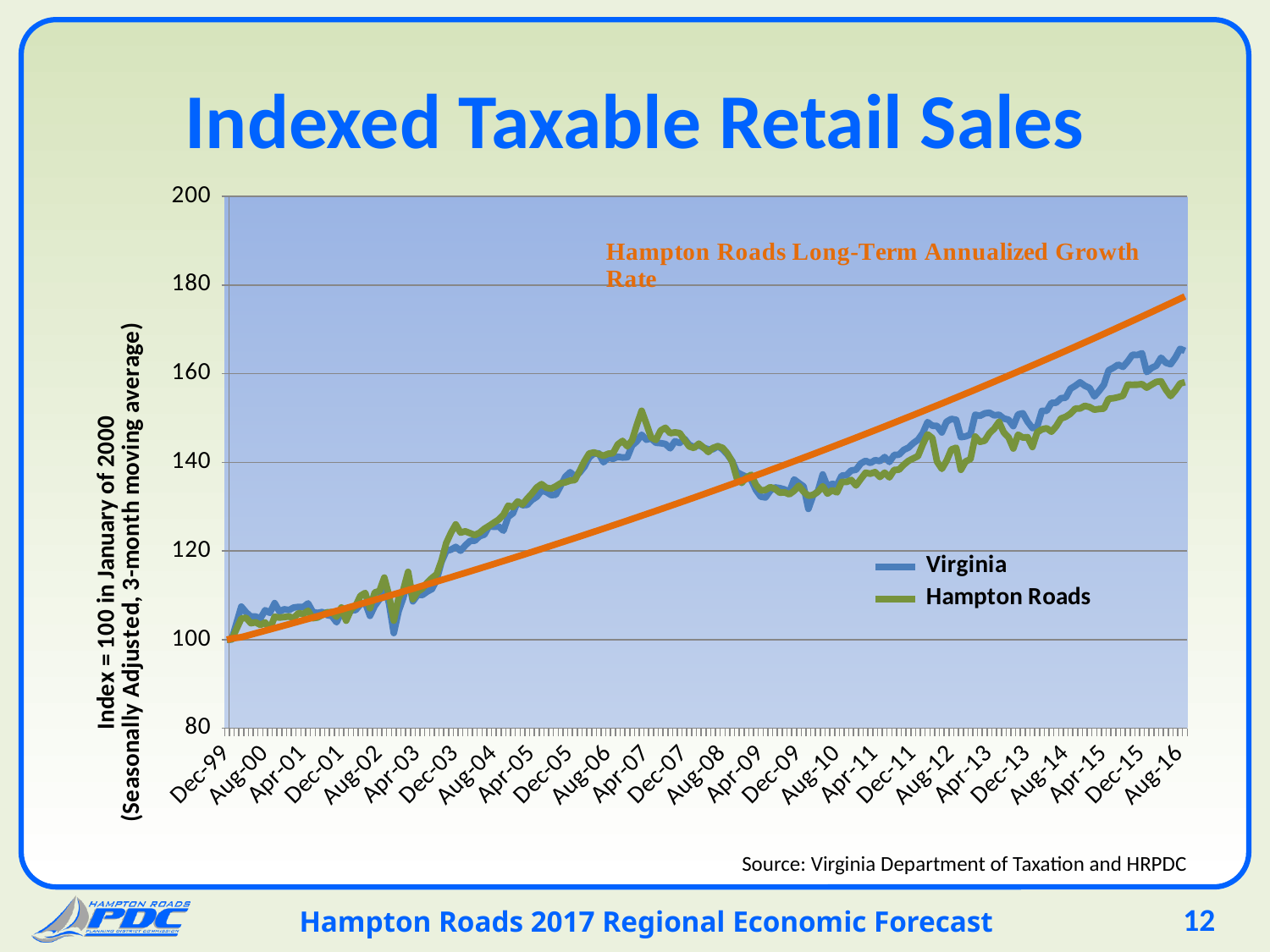
What does the orange line on the chart represent? Hampton Roads Long-Term Annualized Growth Rate What is the title of the chart? Indexed Taxable Retail Sales At Aug-16, which series has the higher value, Virginia or Hampton Roads? Virginia Is the value for Hampton Roads at Aug-16 greater or less than 140? greater Is the Hampton Roads Long-Term Annualized Growth Rate line at Aug-16 greater or less than 180? less Is the value for Virginia at Aug-16 greater or less than 160? greater Overall, do the Virginia and Hampton Roads index values rise or fall from Dec-99 to Aug-16? rise What kind of chart is shown on the slide? line chart How many series does the legend list? 2 What is the index value for both series in January of 2000? 100